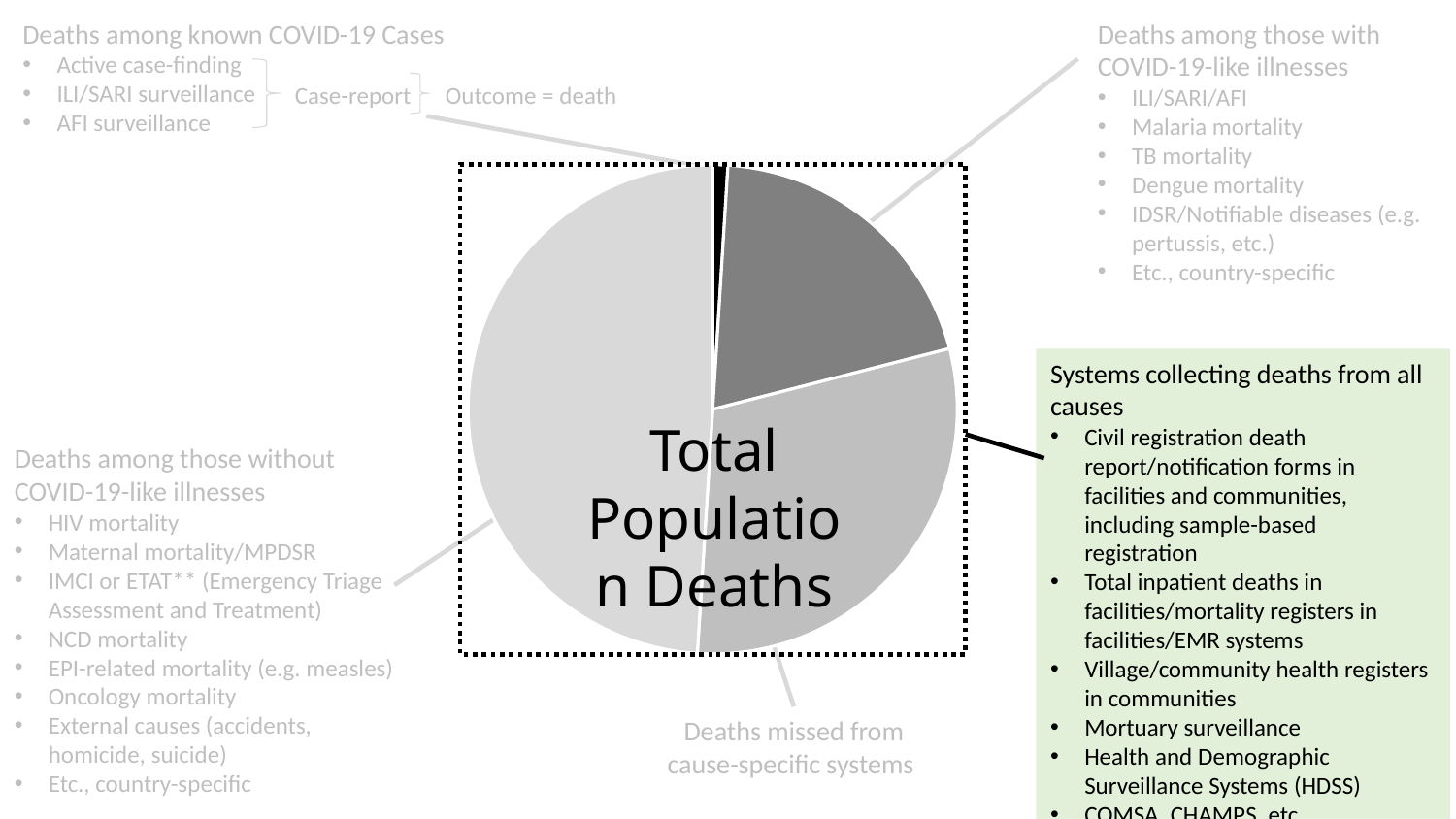
Which slice is larger: Deaths among those with COVID-19-like illnesses or Deaths missed from cause-specific systems? Deaths missed from cause-specific systems Does the pie chart show a legend? No What colour is the slice for Deaths among known COVID-19 Cases? black Which slice of the pie chart is the smallest? Deaths among known COVID-19 Cases Which slice is larger: Deaths among those without COVID-19-like illnesses or Deaths missed from cause-specific systems? Deaths among those without COVID-19-like illnesses Which slice of the pie chart is the largest? Deaths among those without COVID-19-like illnesses Which slice is larger: Deaths among known COVID-19 Cases or Deaths among those with COVID-19-like illnesses? Deaths among those with COVID-19-like illnesses What kind of chart is shown on the slide? pie chart How many slices does the pie chart have? 4 What text is written in the centre of the pie chart? Total Population Deaths